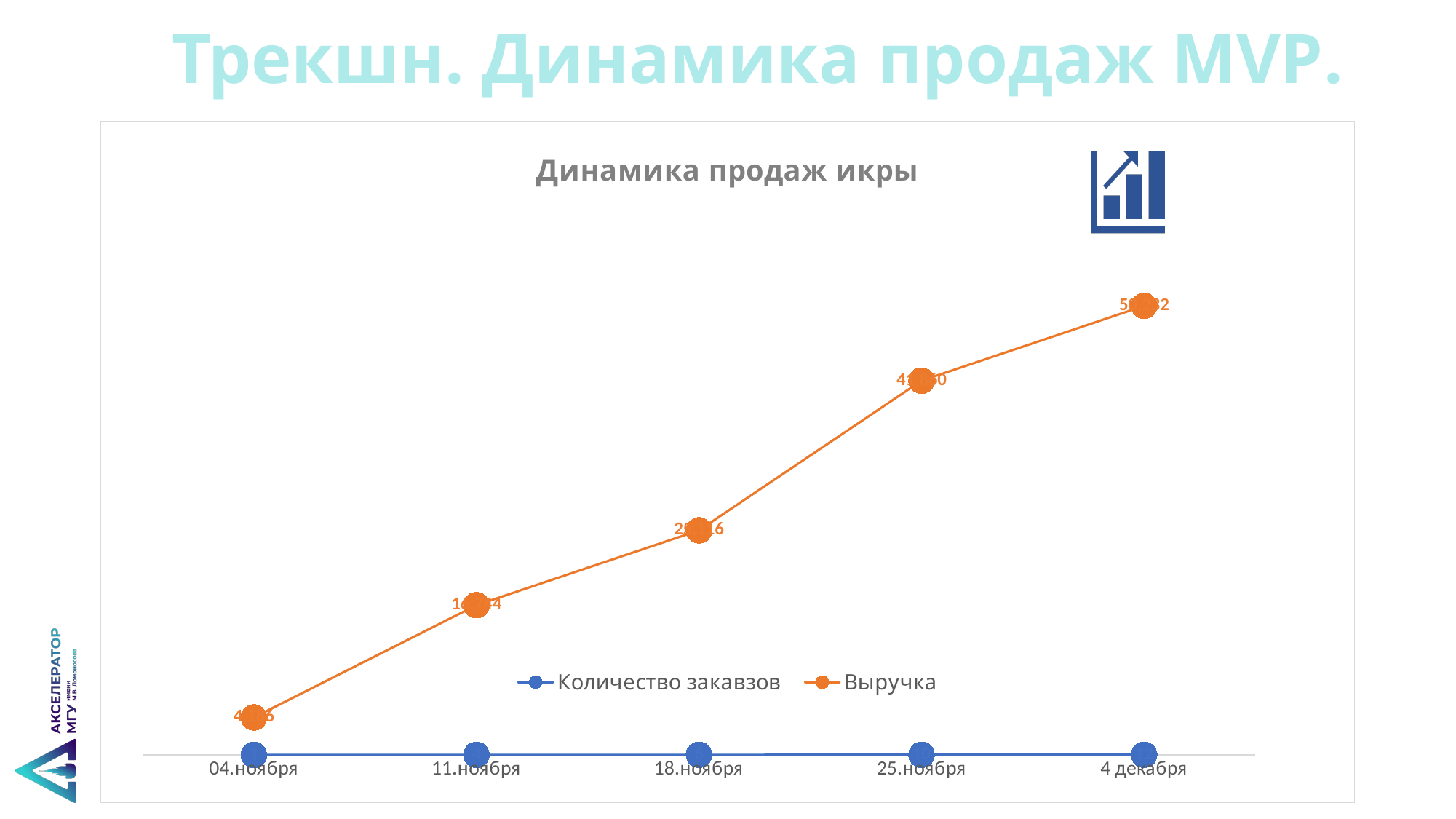
Does the Выручка series rise or fall from 04.ноября to 4 декабря? rise Which date has the larger Выручка value, 11.ноября or 04.ноября? 11.ноября On which date is the Выручка value lowest? 04.ноября How many dates are shown on the x axis? 5 Which date has the larger Выручка value, 18.ноября or 25.ноября? 25.ноября Which series is plotted in orange? Выручка Which series are listed in the legend? Количество закавзов, Выручка How many series does the legend list? 2 What is the title of the chart? Динамика продаж икры What kind of chart is shown on the slide? line chart On which date is the Выручка value highest? 4 декабря